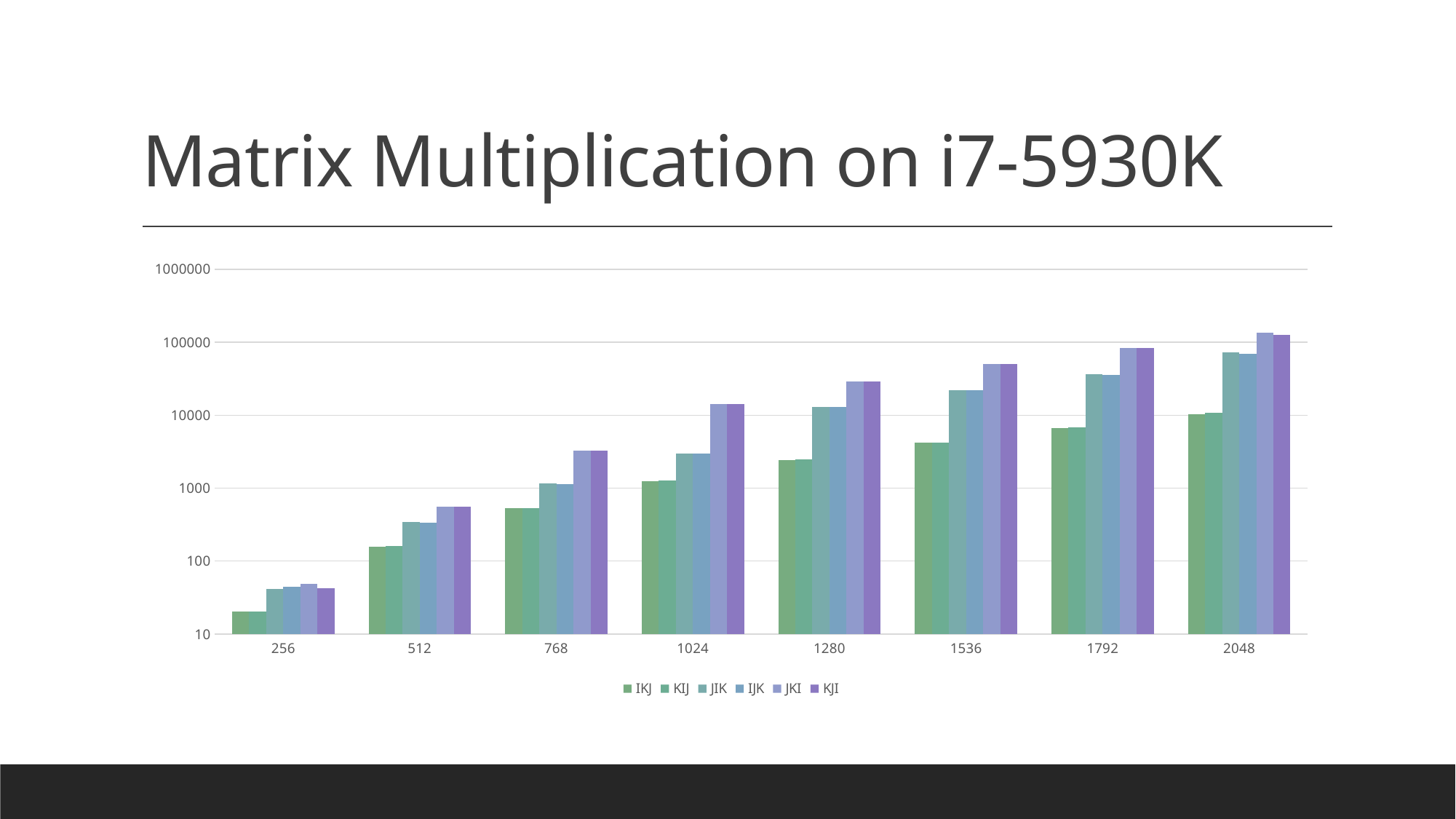
What kind of chart is shown on the slide? bar chart Is the value for JKI at 2048 greater or less than 100000? greater Is the value for KJI at 1536 greater or less than 10000? greater For the JKI series, which category has the highest value? 2048 What is the highest tick value shown on the y axis? 1000000 Is the value for IKJ at 512 greater or less than 100? greater Do the values for the IKJ series rise or fall as the matrix size increases along the x axis? rise How many matrix-size categories are shown on the x axis? 8 How many series does the legend list? 6 What is the title of the chart? Matrix Multiplication on i7-5930K At 1024, which is larger: the value for IKJ or the value for JKI? JKI